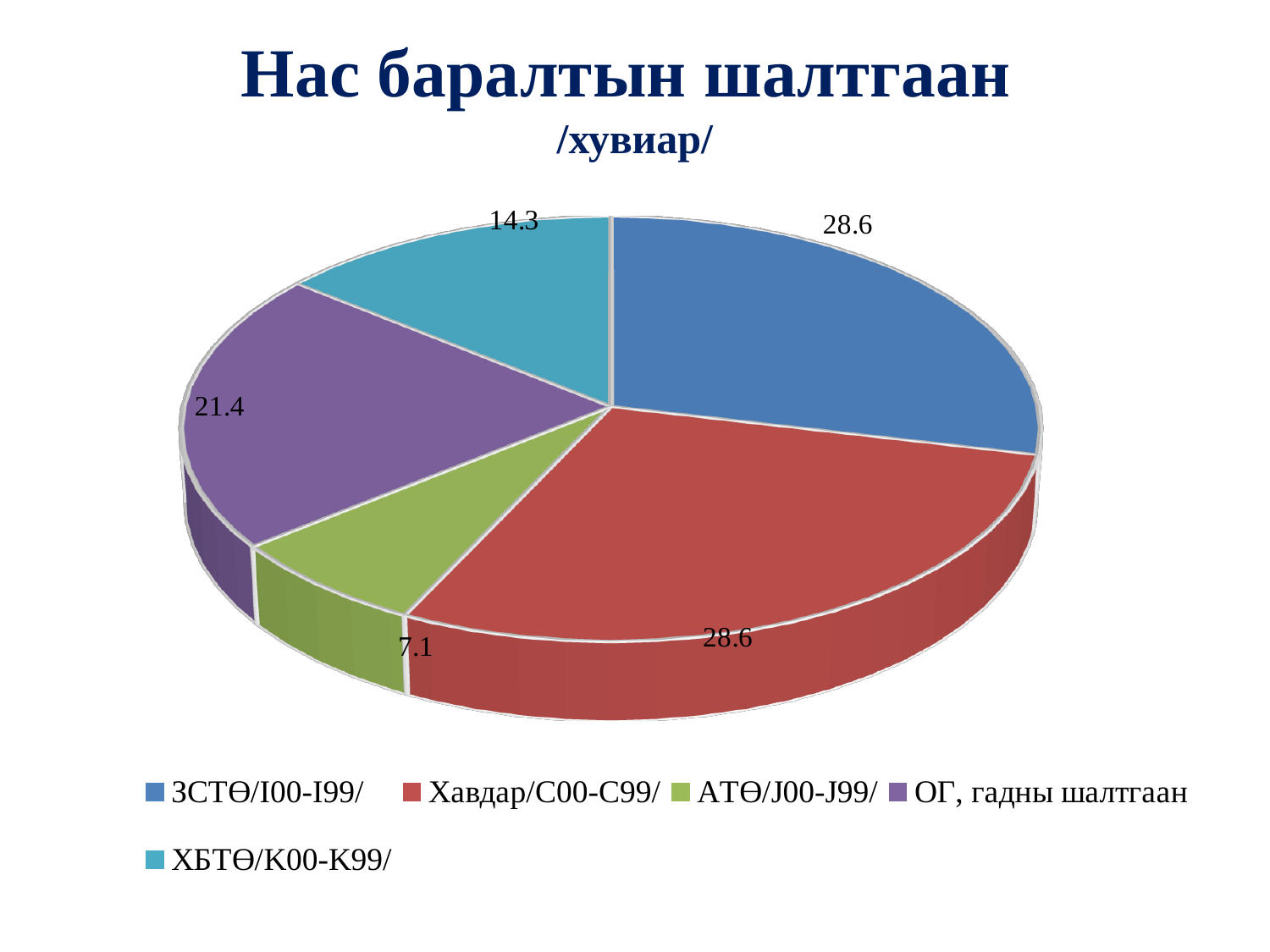
What is the difference between the values for ЗСТӨ/I00-I99/ and АТӨ/J00-J99/? 21.5 What is the value for ЗСТӨ/I00-I99/? 28.6 What is the value for Хавдар/C00-C99/? 28.6 What is the value for ХБТӨ/K00-K99/? 14.3 What is the difference between the values for ОГ, гадны шалтгаан and ХБТӨ/K00-K99/? 7.1 What is the title of the chart? Нас баралтын шалтгаан /хувиар/ What is the value for АТӨ/J00-J99/? 7.1 How many slices does the pie chart have? 5 Which category has the smallest slice? АТӨ/J00-J99/ What is the value for ОГ, гадны шалтгаан? 21.4 What kind of chart is shown on the slide? pie chart Which is larger, ОГ, гадны шалтгаан or ХБТӨ/K00-K99/? ОГ, гадны шалтгаан